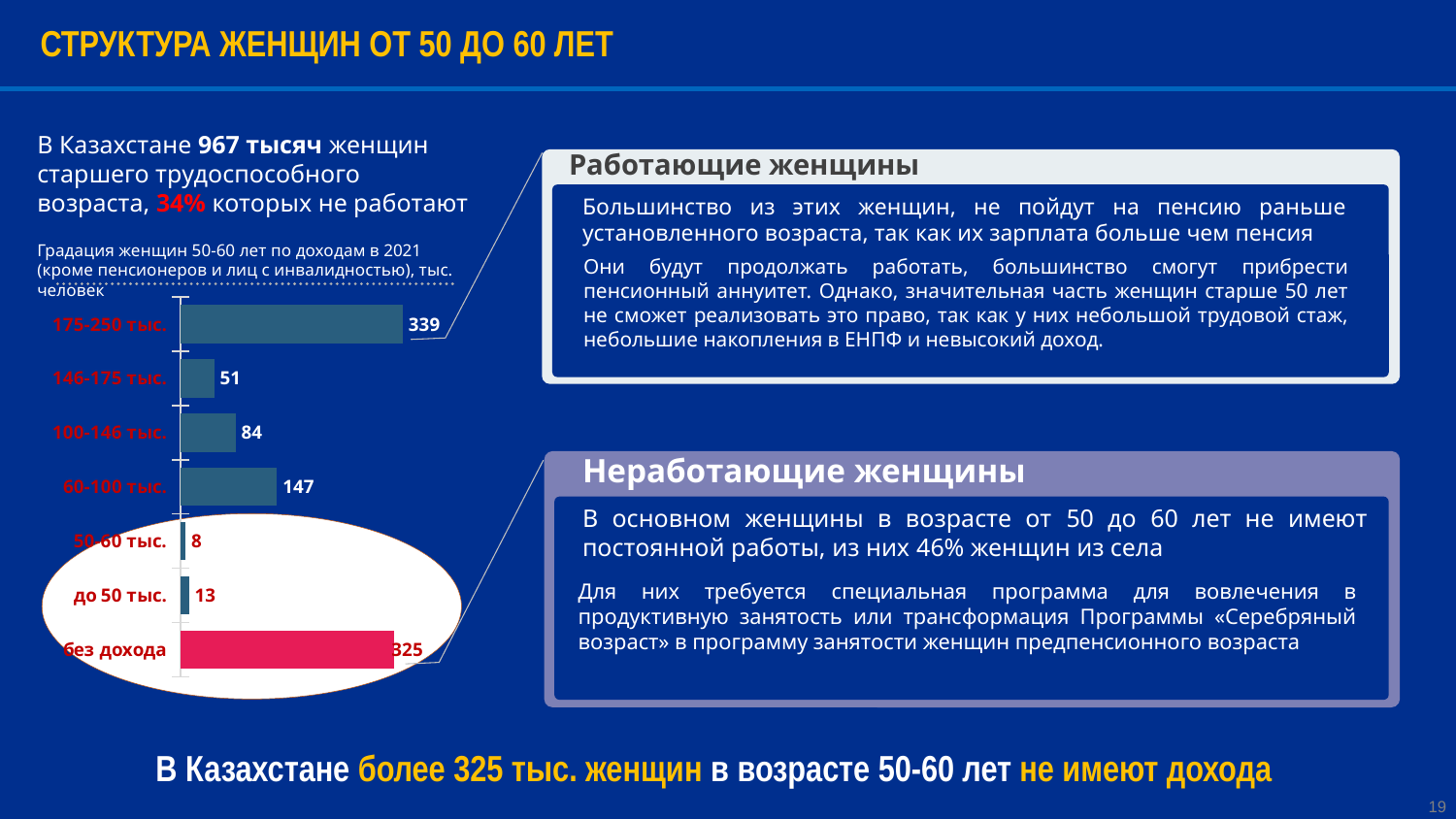
What is the difference between the values for '175-250 тыс.' and 'без дохода'? 14 How many income categories are shown in the bar chart? 7 What type of chart is shown on the slide? bar chart What is the value for the category '60-100 тыс.'? 147 What is the value for the category 'до 50 тыс.'? 13 What is the value for the category '146-175 тыс.'? 51 Which is larger: the value for '100-146 тыс.' or the value for '146-175 тыс.'? 100-146 тыс. Which category has the highest value in the bar chart? 175-250 тыс. What is the value for the category 'без дохода'? 325 What is the value for the category '175-250 тыс.'? 339 Which category has the lowest value in the bar chart? 50-60 тыс. What is the difference between the values for '60-100 тыс.' and '100-146 тыс.'? 63